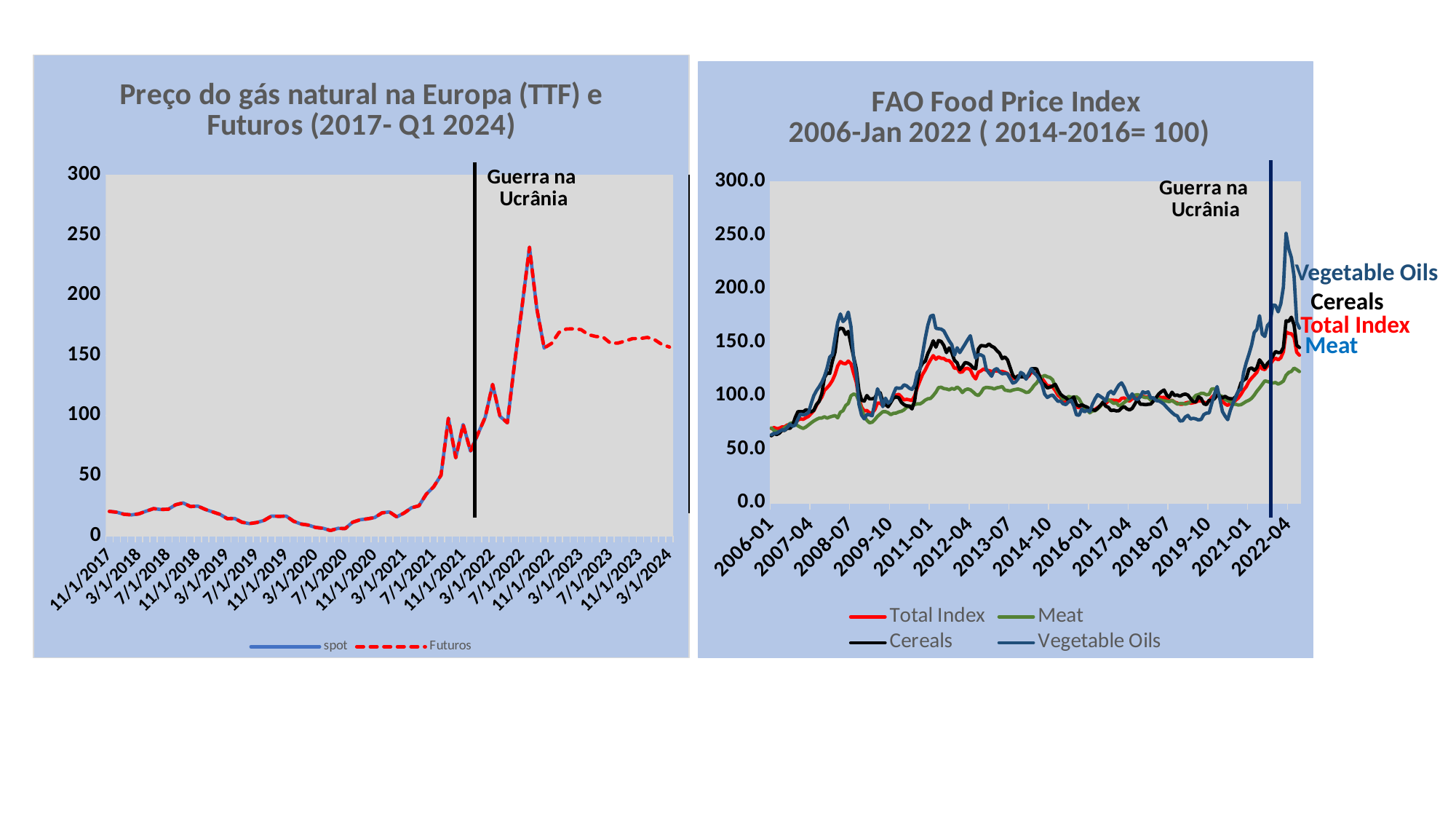
What kind of chart is the right chart, 'FAO Food Price Index'? Line chart In the right chart (FAO Food Price Index), is the Meat value at 2006-01 greater or less than 100? less What event is marked by the vertical line annotation on both charts? Guerra na Ucrânia How many series does the legend of the right chart (FAO Food Price Index) list? 4 In the right chart (FAO Food Price Index), which series reaches the highest value on the chart? Vegetable Oils How many series does the legend of the left chart (natural gas price) list? 2 In the left chart (natural gas price), is the value at 11/1/2017 greater or less than 50? less In the right chart (FAO Food Price Index), is the peak value of Vegetable Oils in 2022 greater or less than 200? greater In the right chart (FAO Food Price Index), which series has the lowest peak value over the period shown? Meat What kind of chart is the left chart, 'Preço do gás natural na Europa (TTF) e Futuros (2017- Q1 2024)'? Line chart